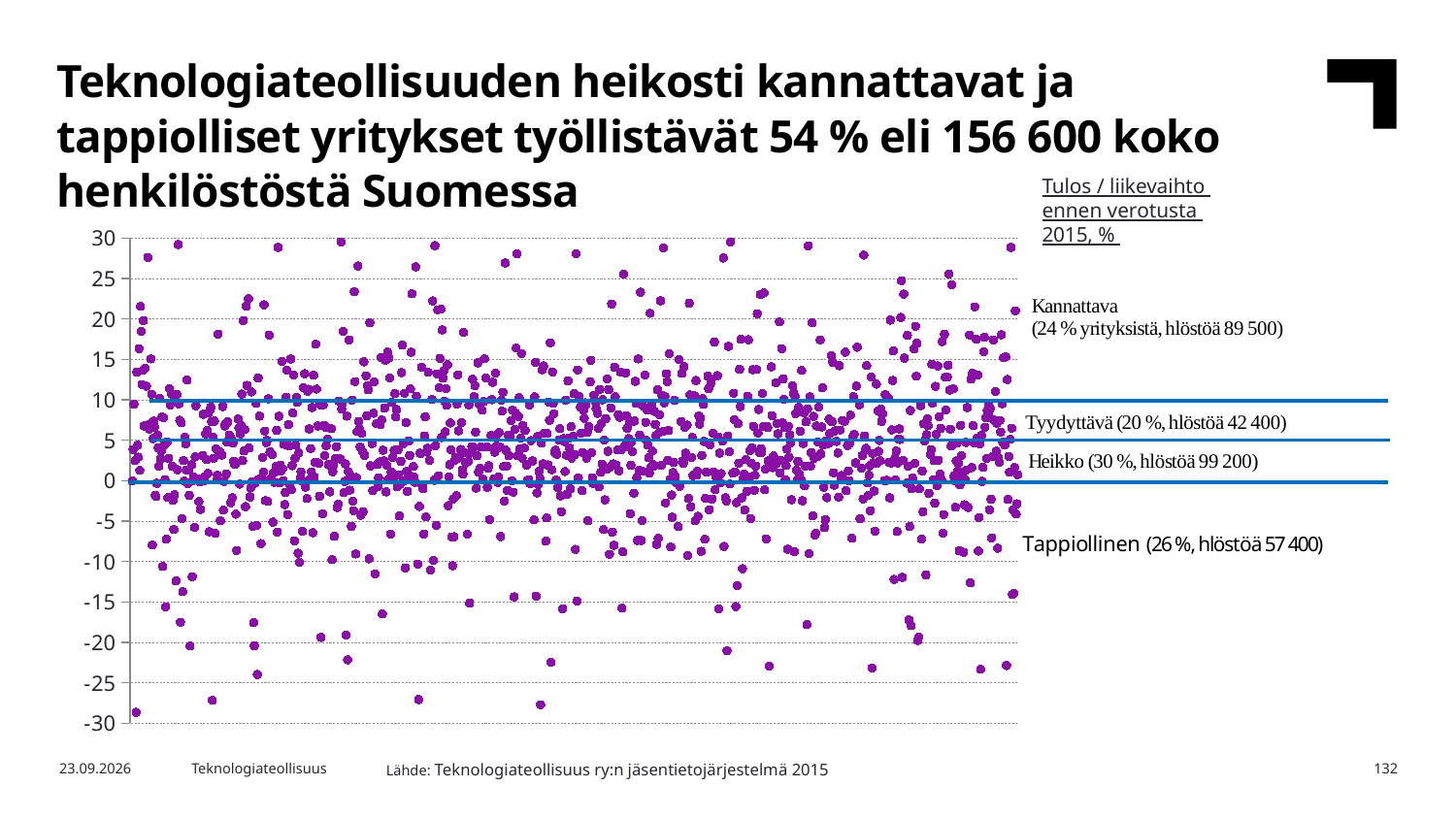
Which category has more personnel, Kannattava or Tappiollinen? Kannattava What is the title of the chart? Tulos / liikevaihto ennen verotusta 2015, % According to the chart annotation, how many personnel (hlöstöä) are in the Kannattava category? 89 500 Which labelled category has the largest number of personnel? Heikko What percentage of companies does the chart annotation give for the Tyydyttävä category? 20 % How many personnel (hlöstöä) does the chart annotation give for the Tappiollinen category? 57 400 What kind of chart is shown on the slide? scatter chart How many profitability categories (Kannattava, Tyydyttävä, Heikko, Tappiollinen) are labelled on the chart? 4 How many personnel (hlöstöä) does the chart annotation give for the Heikko category? 99 200 Which labelled category has the smallest number of personnel? Tyydyttävä What is the difference in personnel between the Heikko and Tappiollinen categories? 41 800 What is the highest value shown on the vertical axis of the chart? 30